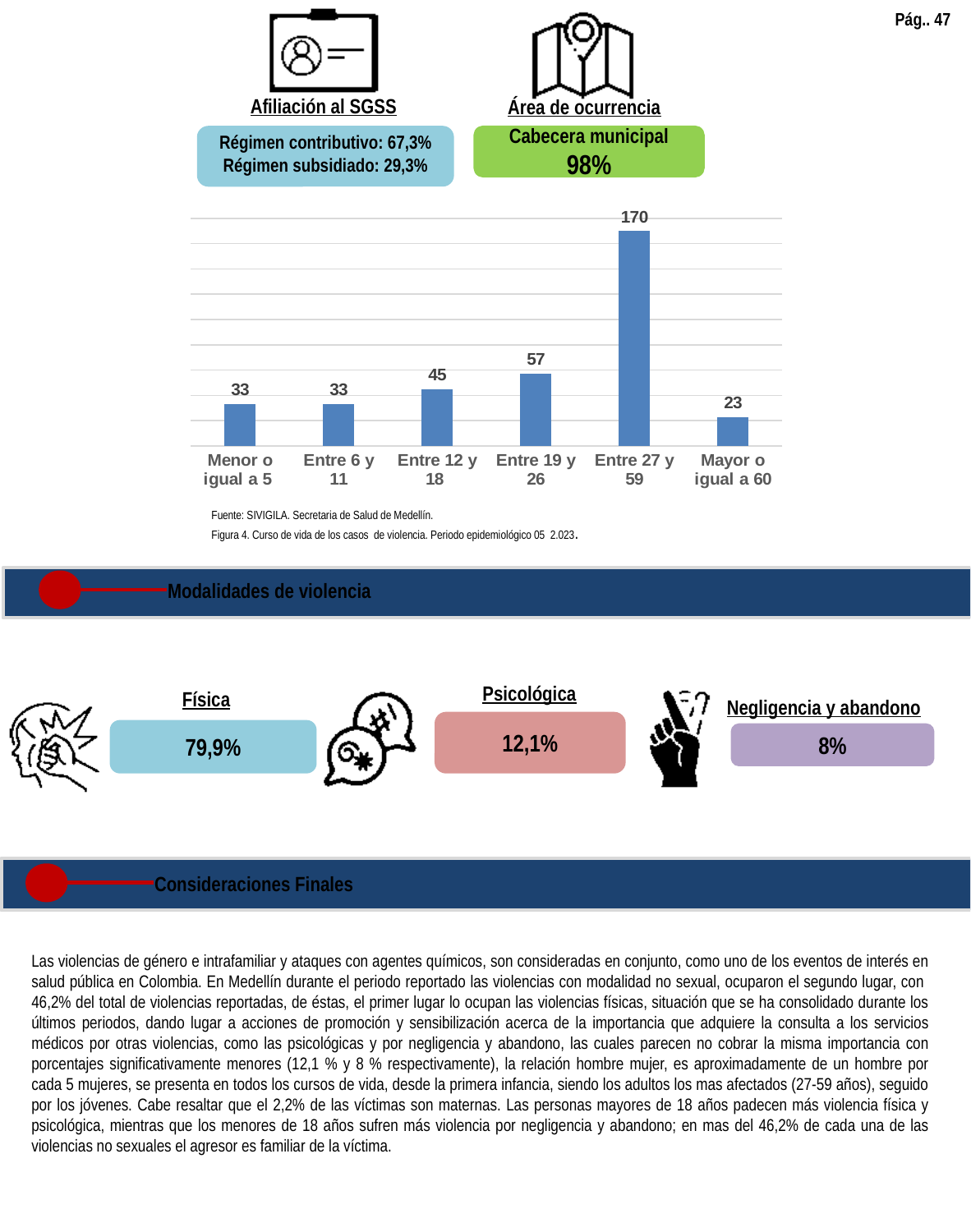
Which category has the highest value in the bar chart? Entre 27 y 59 What is the value for the 'Entre 12 y 18' category in the bar chart? 45 What is the value for the 'Mayor o igual a 60' category in the bar chart? 23 What is the value for the 'Entre 19 y 26' category in the bar chart? 57 According to the caption, what figure number is the bar chart? Figura 4 Which is larger in the bar chart, the value for 'Entre 19 y 26' or the value for 'Entre 12 y 18'? Entre 19 y 26 What is the difference between the values for 'Entre 12 y 18' and 'Mayor o igual a 60' in the bar chart? 22 What kind of chart is shown on the slide? Bar chart What is the value for the 'Entre 27 y 59' category in the bar chart? 170 What is the difference between the values for 'Entre 27 y 59' and 'Entre 19 y 26' in the bar chart? 113 How many categories are shown in the bar chart? 6 Which category has the lowest value in the bar chart? Mayor o igual a 60